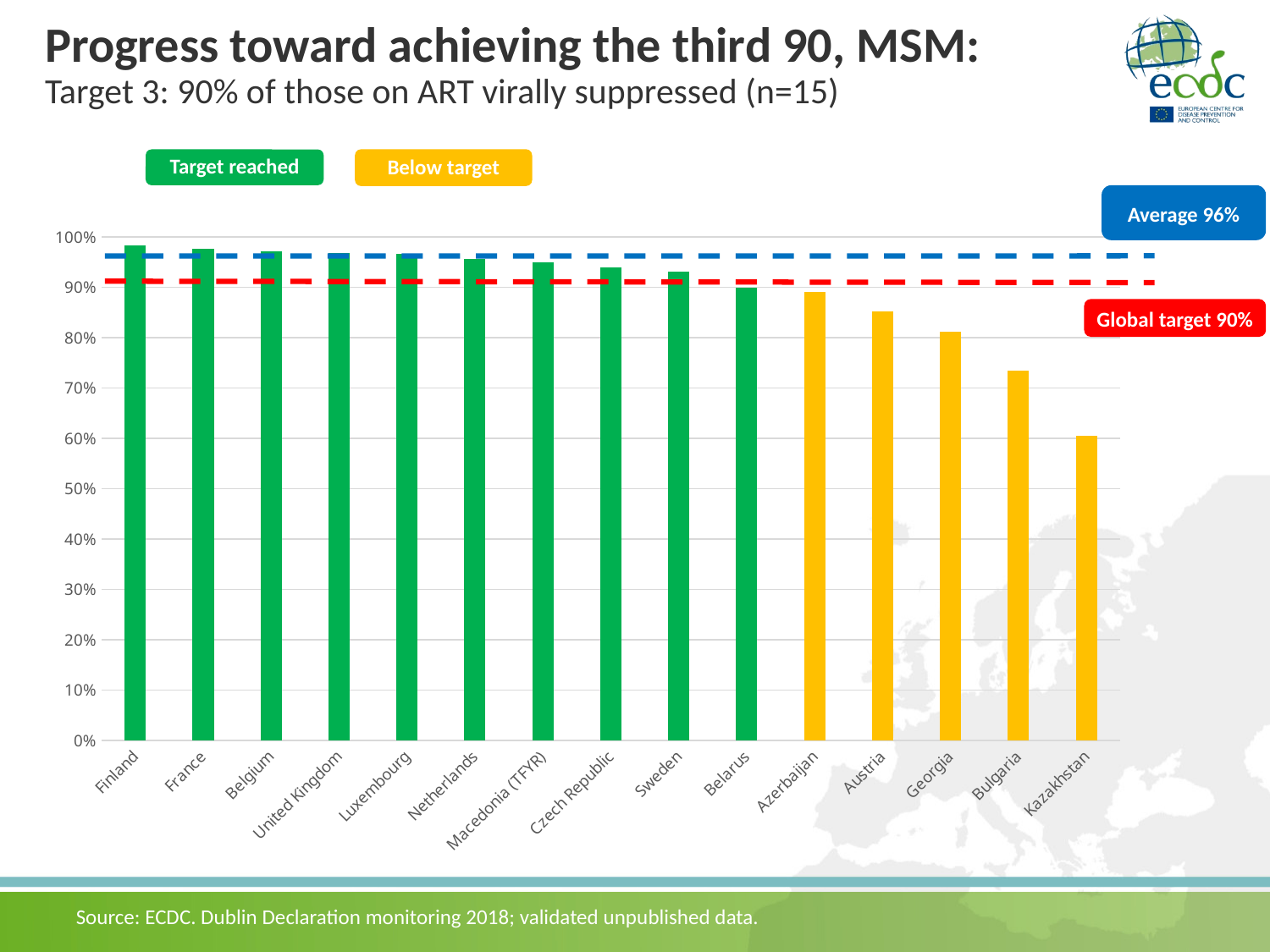
Is the value for Bulgaria greater or less than 70%? greater Is the value for Kazakhstan greater or less than 70%? less Which has the larger value, Austria or Bulgaria? Austria Is the value for Belarus greater or less than 80%? greater What kind of chart is shown on the slide? bar chart How many countries are shown on the x axis of the chart? 15 What does the red dashed line represent according to its label? Global target 90% Do the bar values rise or fall from left to right along the x axis? fall Which country has the highest bar in the chart? Finland What average value is shown by the blue dashed line label? Average 96% Which country has the lowest bar in the chart? Kazakhstan